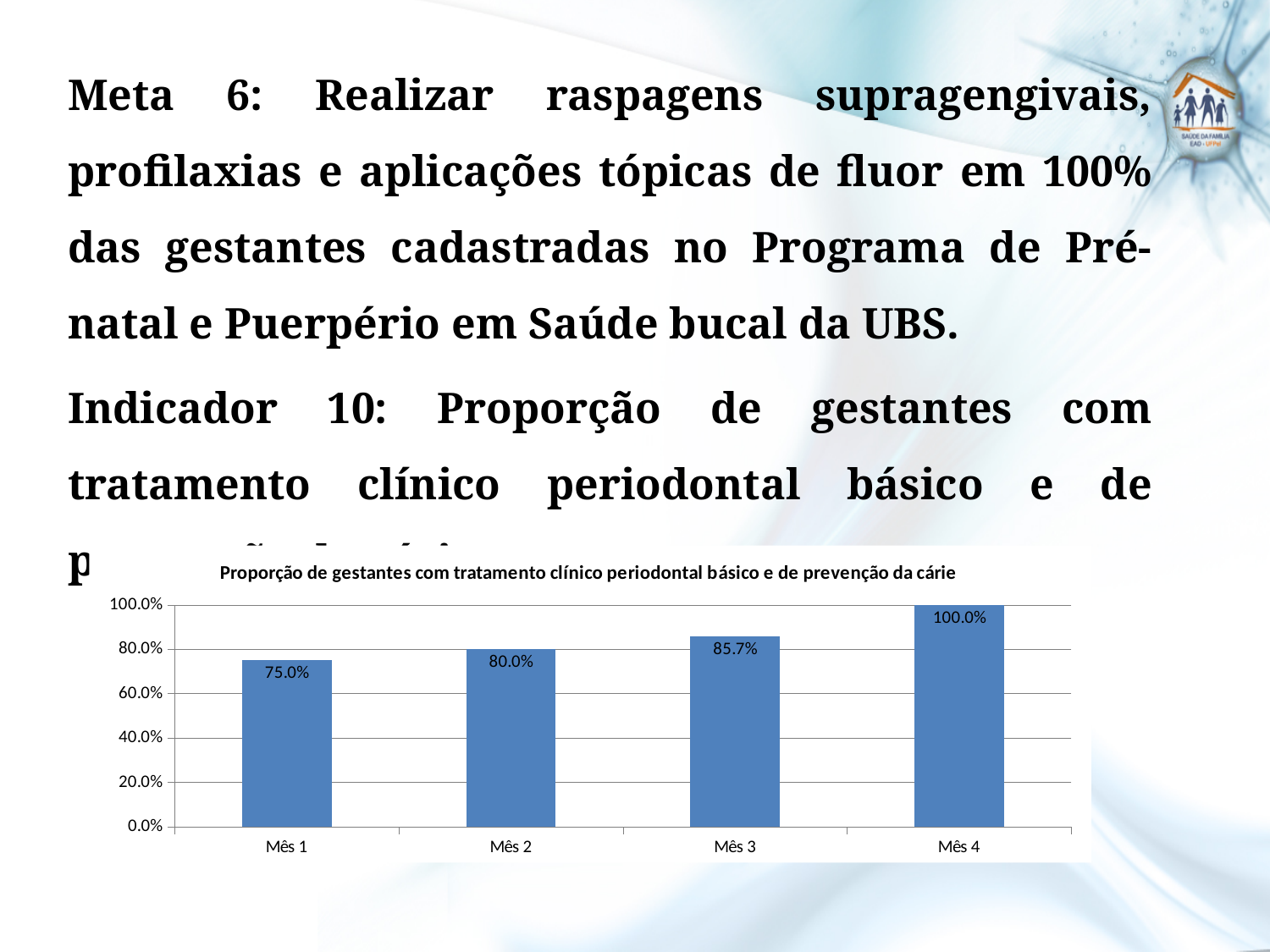
What kind of chart is shown on the slide? bar chart Do the values rise or fall from Mês 1 to Mês 4? rise What is the value for Mês 4? 100.0% How many months are shown on the x axis? 4 Is the value for Mês 3 greater or less than 80.0%? greater What is the value for Mês 1? 75.0% What is the difference between the values for Mês 4 and Mês 1? 25.0% Which is larger, the value for Mês 2 or the value for Mês 3? Mês 3 Which month has the lowest value? Mês 1 What is the value for Mês 3? 85.7% What is the value for Mês 2? 80.0% Which month has the highest value? Mês 4